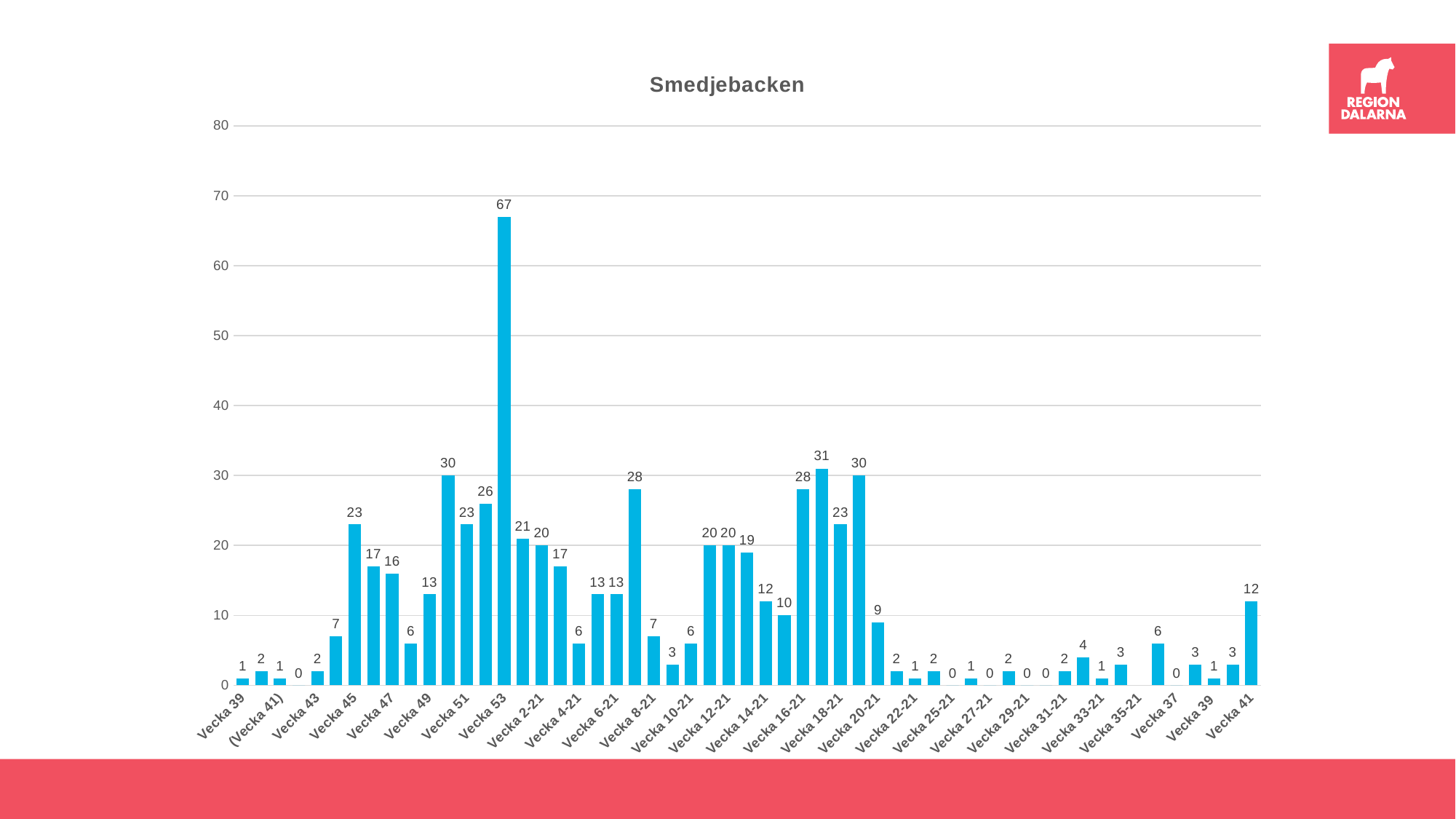
What is the value for Vecka 20-21? 9 What is the difference between the values for Vecka 53 and Vecka 16-21? 39 What is the value for Vecka 16-21? 28 Which week has the highest value in the chart? Vecka 53 What is the value for Vecka 45? 23 What is the value for Vecka 49? 13 Is the value for Vecka 53 greater or less than 60? greater What kind of chart is shown on the slide? bar chart Which is larger, the value for Vecka 45 or the value for Vecka 20-21? Vecka 45 What is the value for Vecka 53? 67 What is the title of the chart? Smedjebacken What is the value for the last week shown, Vecka 41? 12